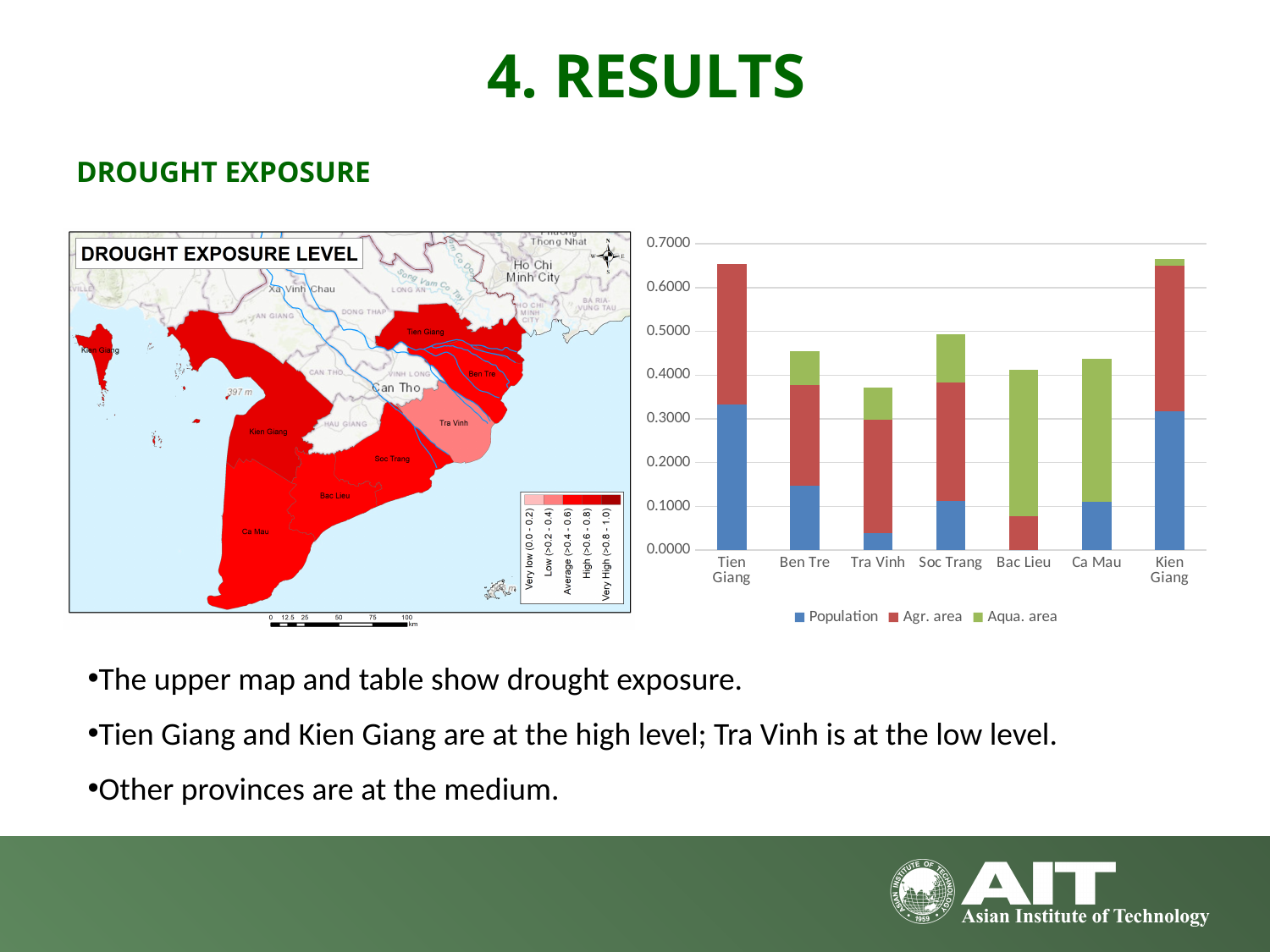
What kind of chart is shown on the right of the slide? stacked bar chart Which province has the lowest total stacked bar in the chart? Tra Vinh Which has the larger total stacked bar, Tien Giang or Ben Tre? Tien Giang Which has the larger total stacked bar, Tra Vinh or Soc Trang? Soc Trang Is the total stacked value for Ben Tre greater or less than 0.4000? greater How many provinces are shown on the x axis of the bar chart? 7 Which has the larger Population value, Ben Tre or Tra Vinh? Ben Tre How many series does the legend of the bar chart list? 3 Which colour represents the Aqua. area series in the bar chart? green Is the total stacked value for Tra Vinh greater or less than 0.4000? less Is the total stacked value for Kien Giang greater or less than 0.6000? greater